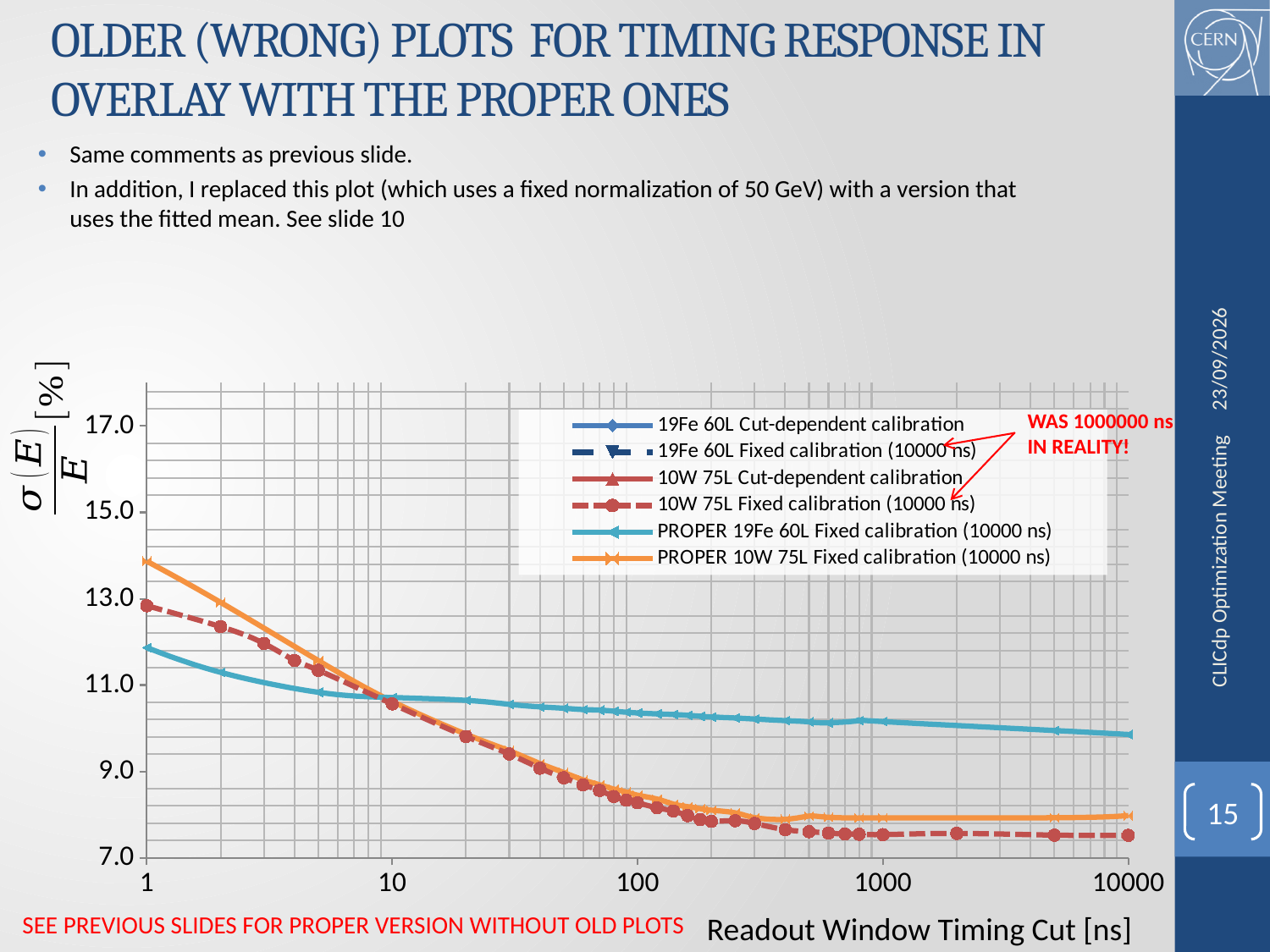
Is the value of the PROPER 10W 75L Fixed calibration series at 10000 ns greater or less than 9.0? less At 1 ns, which series has the higher value: PROPER 10W 75L Fixed calibration or PROPER 19Fe 60L Fixed calibration? PROPER 10W 75L Fixed calibration What kind of chart is shown on the slide? line chart Is the value of the PROPER 19Fe 60L Fixed calibration series at 10000 ns greater or less than 9.0? greater What is the last entry listed in the chart legend? PROPER 10W 75L Fixed calibration (10000 ns) Is the value of the 10W 75L Fixed calibration (10000 ns) series at 10000 ns greater or less than 9.0? less How many series does the chart legend list? 6 Does the PROPER 10W 75L Fixed calibration series generally rise or fall as the readout window timing cut increases from 1 ns to 1000 ns? fall What is the x-axis title of the chart? Readout Window Timing Cut [ns] At 10000 ns, which series has the higher value: PROPER 19Fe 60L Fixed calibration or 10W 75L Fixed calibration (10000 ns)? PROPER 19Fe 60L Fixed calibration